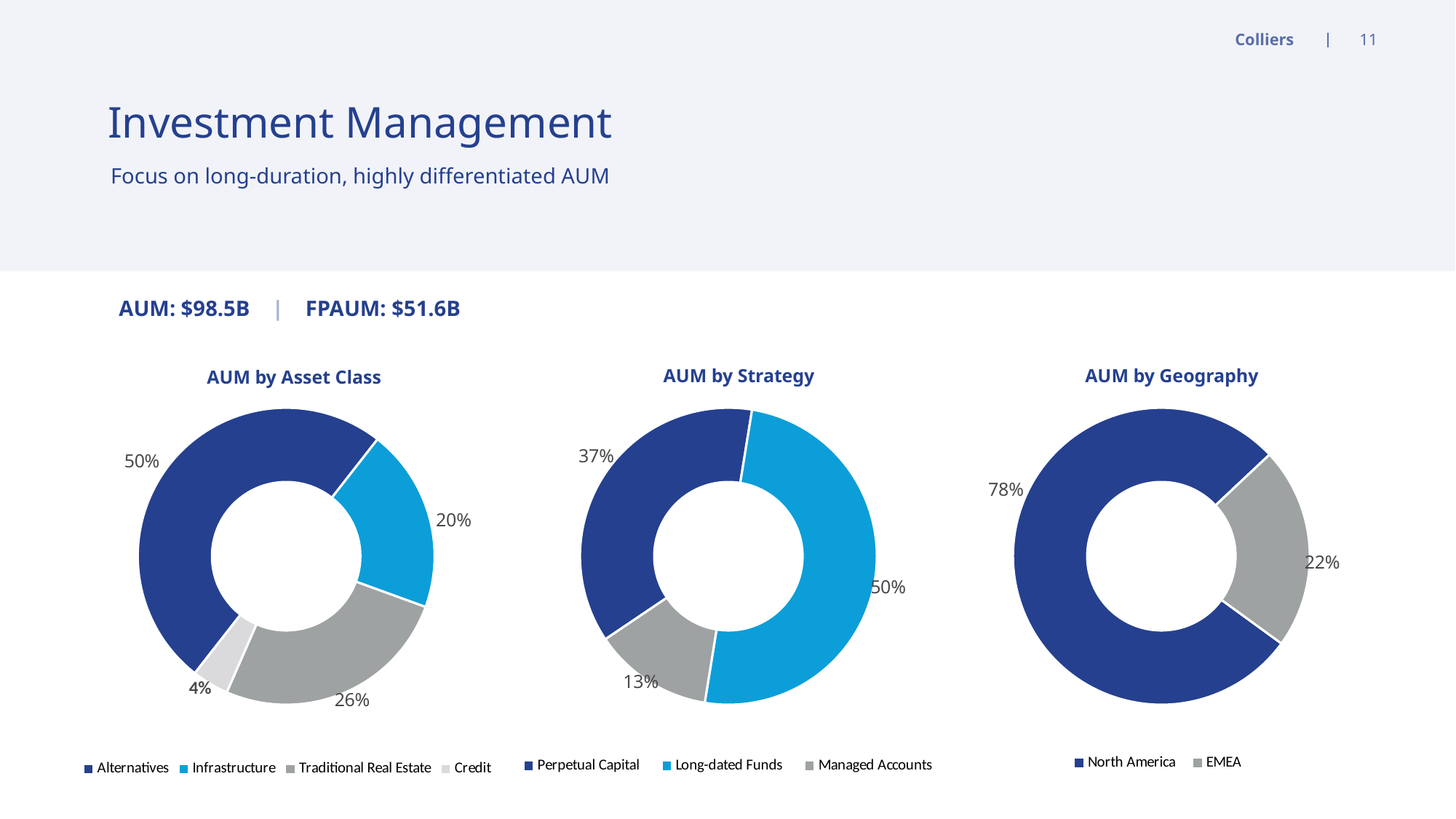
In the AUM by Strategy chart, what share is Managed Accounts? 13% In the AUM by Strategy chart, what share is Perpetual Capital? 37% In the AUM by Geography chart, what is the difference between the North America and EMEA shares? 56% In the AUM by Asset Class chart, which category has the smallest share? Credit What kind of chart is the AUM by Geography chart? Doughnut (pie) chart In the AUM by Strategy chart, which is larger, Perpetual Capital or Managed Accounts? Perpetual Capital In the AUM by Asset Class chart, how many categories does the legend list? 4 In the AUM by Strategy chart, which category has the largest share? Long-dated Funds In the AUM by Asset Class chart, what is the difference between the Infrastructure and Credit shares? 16% In the AUM by Asset Class chart, what share is Traditional Real Estate? 26% In the AUM by Asset Class chart, what share is Alternatives? 50% In the AUM by Geography chart, what share is EMEA? 22%